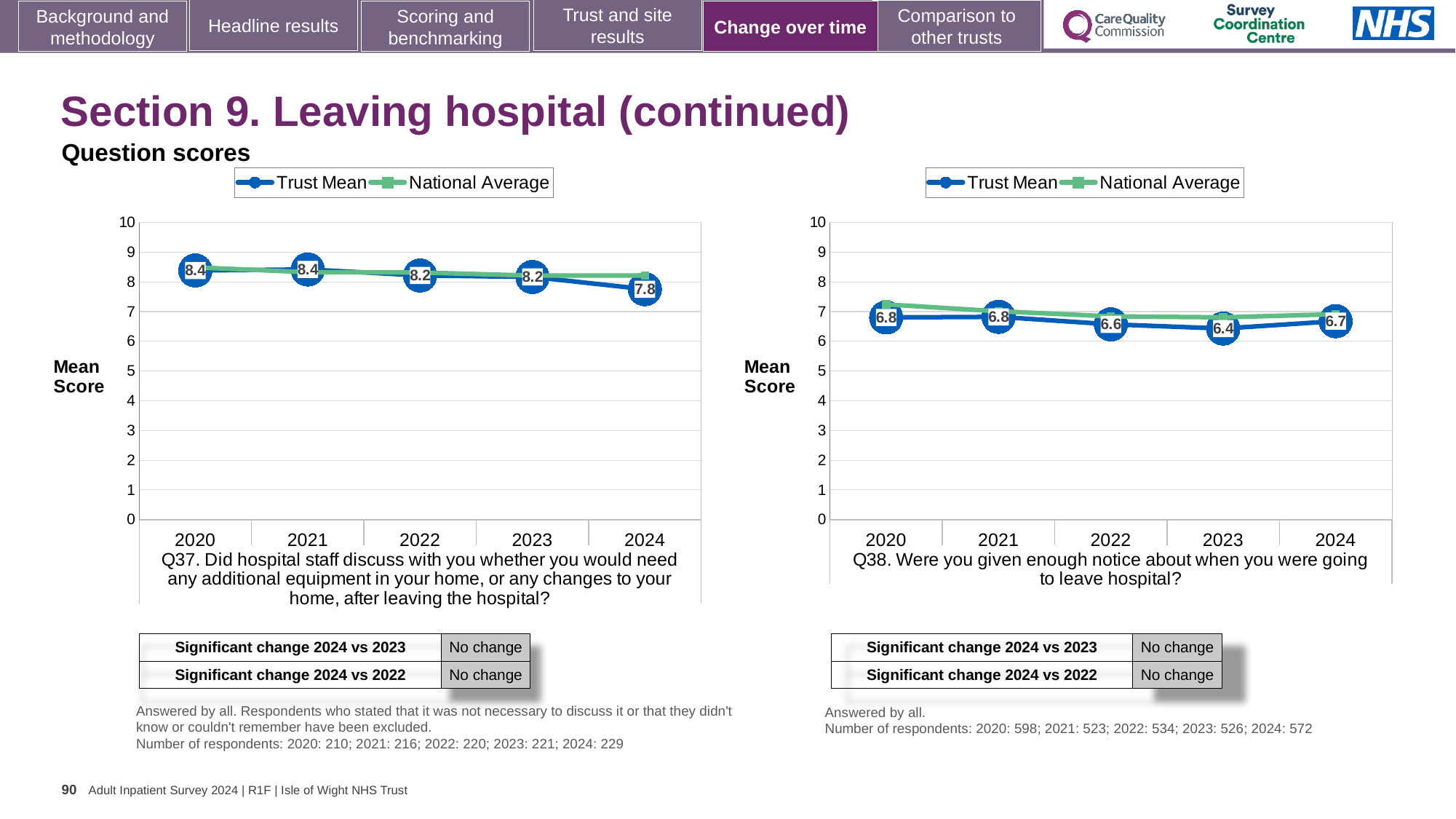
In the Q37 chart, is the Trust Mean score for 2024 greater or less than 7? greater In the Q37 chart, what is the difference between the Trust Mean scores for 2020 and 2024? 0.6 In the Q38 chart, which year has the lowest Trust Mean score? 2023 In the Q37 chart, what is the Trust Mean score for 2020? 8.4 In the Q37 chart, what is the Trust Mean score for 2024? 7.8 In the Q38 chart, is the Trust Mean score for 2022 greater or less than the Trust Mean score for 2023? greater How many years are plotted on the x axis of the Q38 chart? 5 What kind of chart is the Q38 chart? Line chart How many series does the legend of the Q37 chart list? 2 In the Q38 chart, what is the Trust Mean score for 2024? 6.7 In the Q38 chart, what is the Trust Mean score for 2023? 6.4 In the Q37 chart, which year has the lowest Trust Mean score? 2024